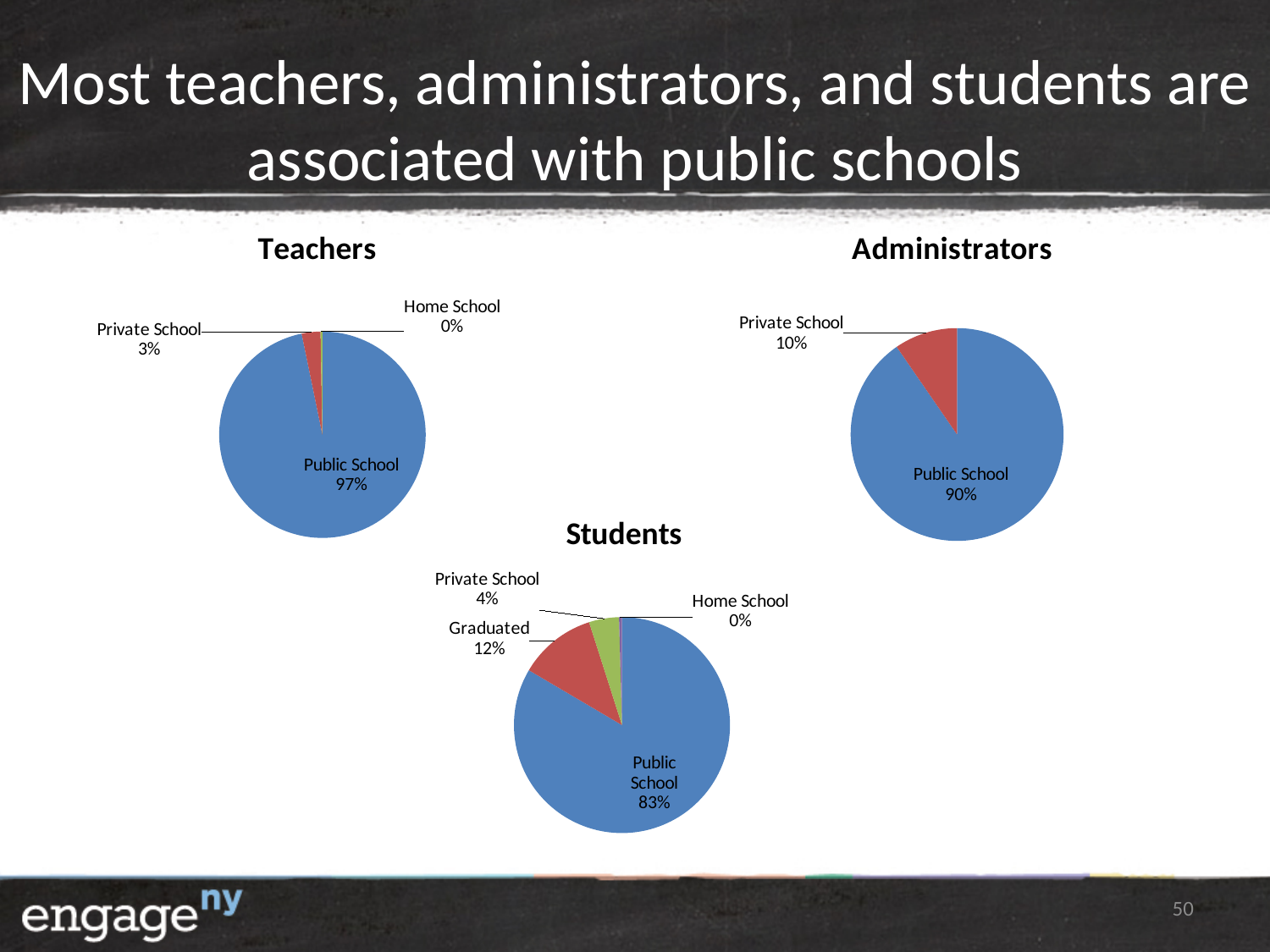
In the Administrators chart, what percentage is labelled for Public School? 90% In the Teachers chart, what is the difference between the Public School and Private School percentages? 94% In the Students chart, what percentage is labelled for Graduated? 12% In the Teachers chart, what share of the pie is Public School? 97% In the Administrators chart, what share of the pie is Private School? 10% What kind of chart is the Administrators chart? Pie chart In the Students chart, how many categories are labelled on the pie? 4 Which is larger: the Public School share in the Teachers chart or the Public School share in the Administrators chart? Teachers In the Students chart, which category has the largest slice? Public School How many pie charts are shown on the slide? 3 In the Teachers chart, what percentage is labelled for Private School? 3% In the Students chart, what share of the pie is Public School? 83%